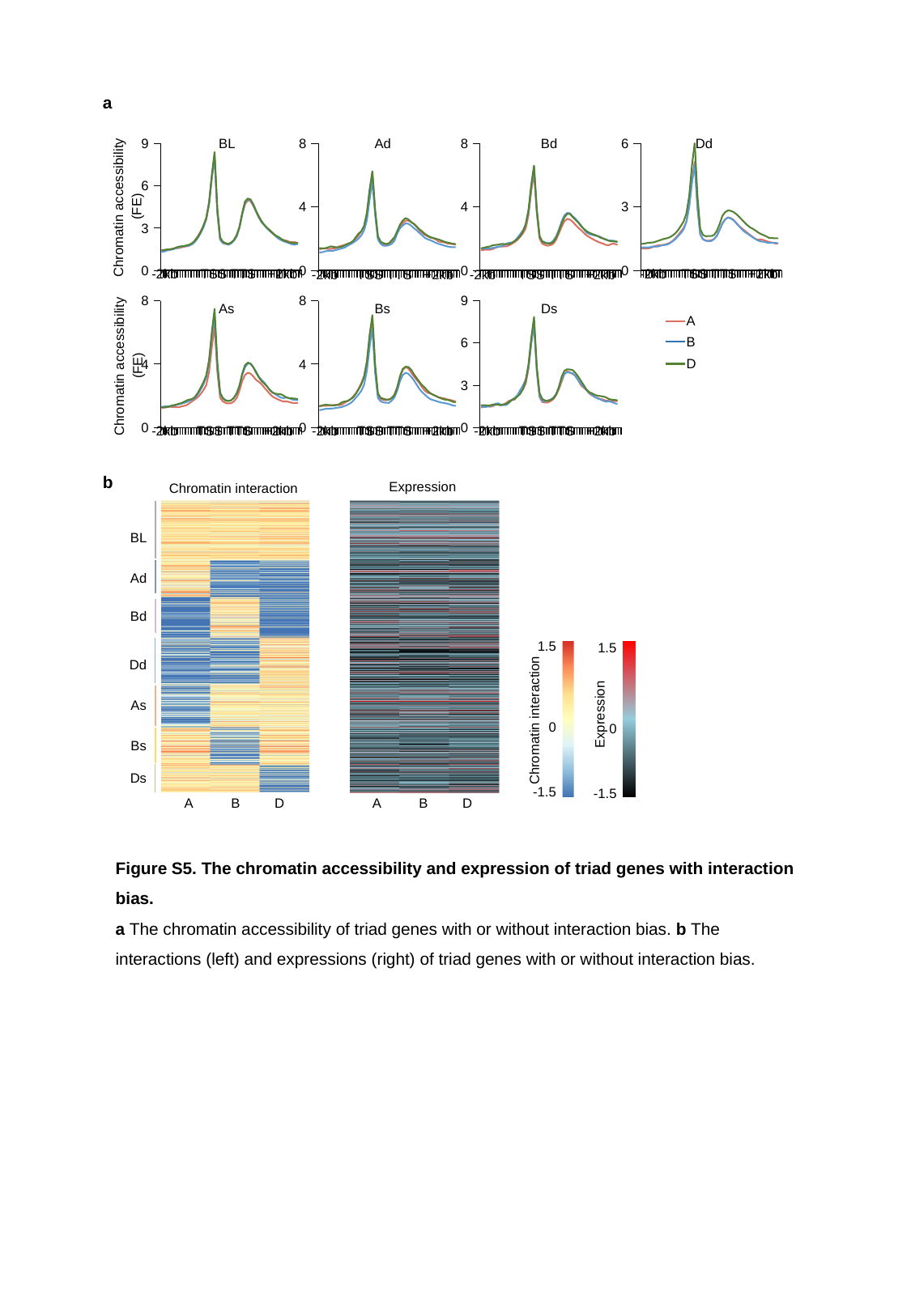
In panel a, how many series does the legend list? 3 In panel a, how many line-chart panels are shown? 7 In panel a, what is the highest y-axis tick value on the BL chart? 9 In panel a, what kind of chart is the BL plot? line chart In panel a, what is the y-axis label of the line charts? Chromatin accessibility (FE) In panel a, is the peak value of the lines in the Dd chart greater or less than 3? greater In panel a, what is the highest y-axis tick value on the Dd chart? 6 In panel a, is the peak value of the lines in the BL chart greater or less than 6? greater In panel a, is the peak value of the lines in the Ds chart greater or less than 6? greater In panel a, which series is drawn in green according to the legend? D In panel b, what are the column labels of the Chromatin interaction heatmap? A, B, D In panel b, what are the minimum and maximum values on the Expression colour scale? -1.5 and 1.5